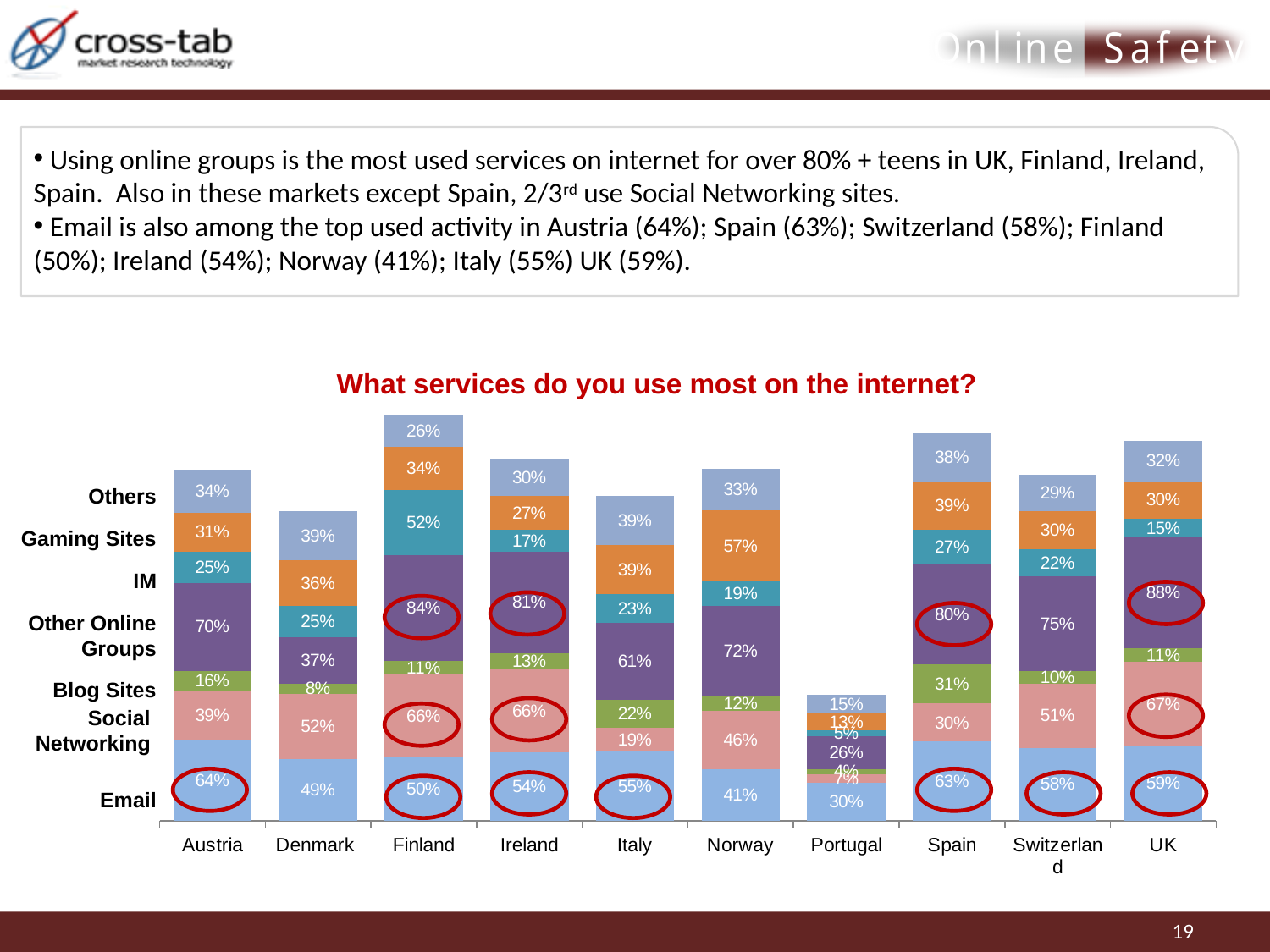
What kind of chart is shown on the slide? Stacked bar chart Which country has the lowest Email value? Portugal How many countries are shown along the x axis of the chart? 10 What is the Gaming Sites value for Norway? 57% How many service categories are listed for each country's bar? 7 What is the Email value for Austria? 64% What is the title of the chart? What services do you use most on the internet? What is the Other Online Groups value for Finland? 84% Which is larger, the Social Networking value for Denmark or for Switzerland? Denmark What is the difference between the Other Online Groups values for the UK and Finland? 4 percentage points Which country has the highest Other Online Groups value? UK What is the total of all segments in the Portugal bar? 100%